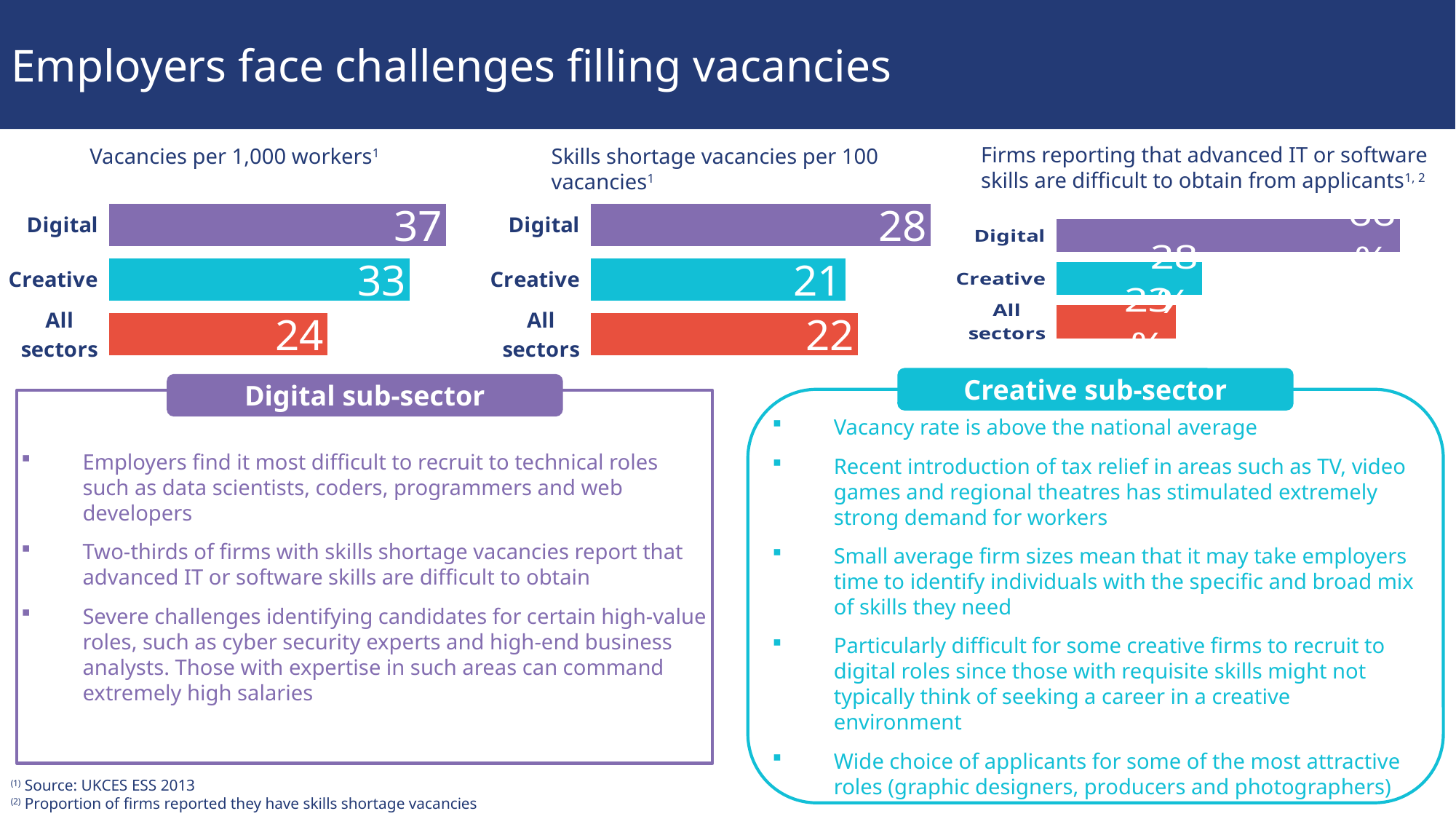
In the 'Skills shortage vacancies per 100 vacancies' chart, which category has the highest value? Digital In the 'Skills shortage vacancies per 100 vacancies' chart, what is the value for Creative? 21 In the 'Vacancies per 1,000 workers' chart, what is the value for All sectors? 24 In the 'Vacancies per 1,000 workers' chart, which category has the lowest value? All sectors In the chart on the right about firms reporting advanced IT or software skills are difficult to obtain, which category has the longest bar? Digital In the 'Skills shortage vacancies per 100 vacancies' chart, what is the value for All sectors? 22 In the 'Vacancies per 1,000 workers' chart, what is the value for Digital? 37 In the 'Vacancies per 1,000 workers' chart, what colour is the Creative bar? Cyan What type of chart is the 'Vacancies per 1,000 workers' chart? Bar chart In the 'Skills shortage vacancies per 100 vacancies' chart, what is the difference between Digital and All sectors? 6 In the 'Vacancies per 1,000 workers' chart, how many categories are shown? 3 In the 'Vacancies per 1,000 workers' chart, what is the difference between Digital and Creative? 4